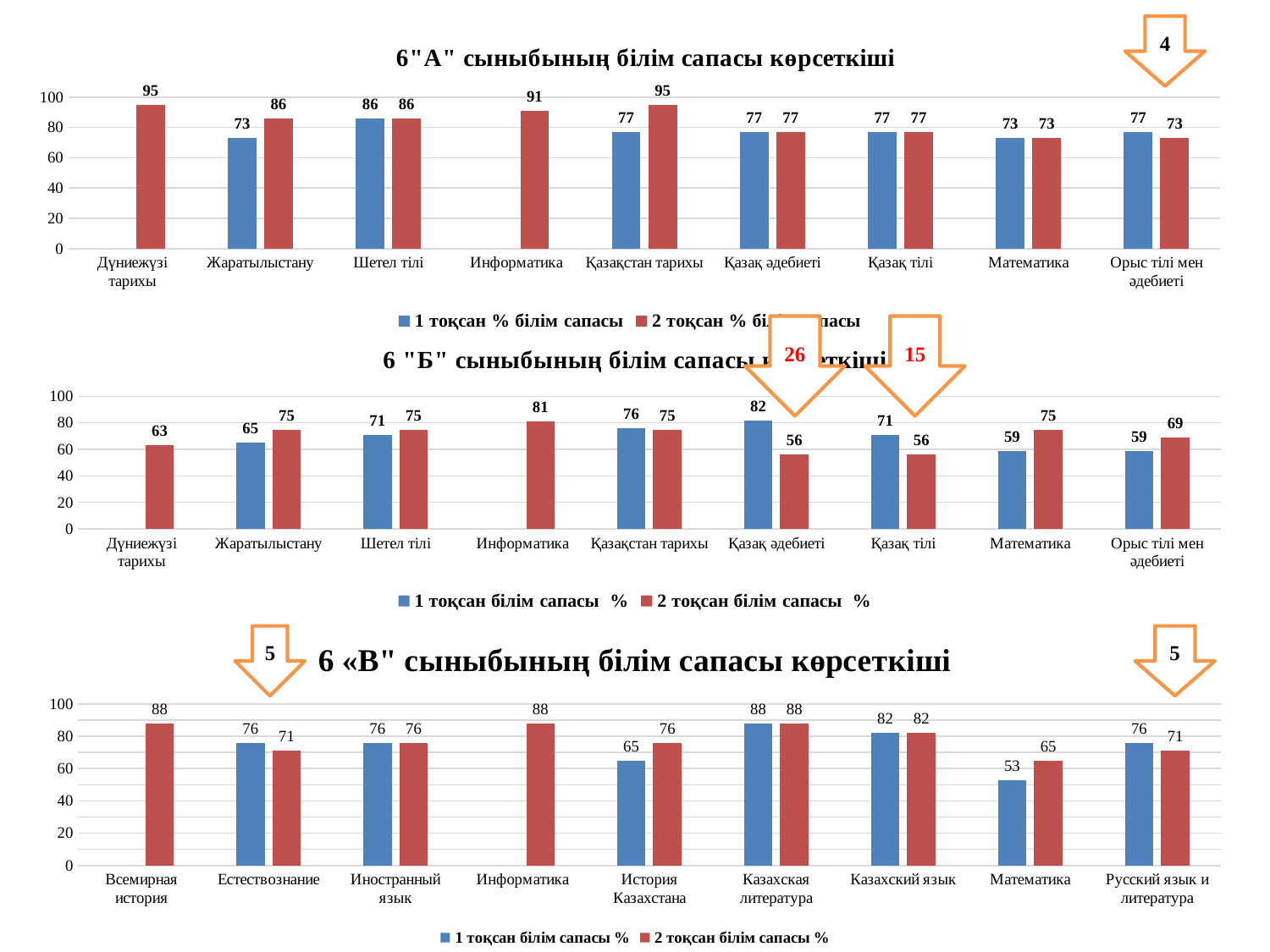
In the chart titled 6"А" сыныбының білім сапасы көрсеткіші, what is the value of the 1 тоқсан series for Жаратылыстану? 73 In the chart titled 6 "Б" сыныбының білім сапасы көрсеткіші, what is the 1 тоқсан value for Қазақ әдебиеті? 82 In the chart titled 6 «В" сыныбының білім сапасы көрсеткіші, how many categories are shown on the x axis? 9 In the chart titled 6 "Б" сыныбының білім сапасы көрсеткіші, which is larger for Математика: the 1 тоқсан value or the 2 тоқсан value? 2 тоқсан (75) In the chart titled 6"А" сыныбының білім сапасы көрсеткіші, what is the value of the 2 тоқсан series for Қазақстан тарихы? 95 In the chart titled 6 «В" сыныбының білім сапасы көрсеткіші, what is the difference between the 2 тоқсан and 1 тоқсан values for История Казахстана? 11 In the chart titled 6"А" сыныбының білім сапасы көрсеткіші, what is the difference between the 2 тоқсан and 1 тоқсан values for Жаратылыстану? 13 What type of chart is the one titled 6 «В" сыныбының білім сапасы көрсеткіші? Bar chart In the chart titled 6 "Б" сыныбының білім сапасы көрсеткіші, which category has the lowest 2 тоқсан value? Қазақ әдебиеті and Қазақ тілі (56) In the chart titled 6 «В" сыныбының білім сапасы көрсеткіші, what colour are the bars for the 1 тоқсан білім сапасы % series? Blue In the chart titled 6 «В" сыныбының білім сапасы көрсеткіші, what is the 1 тоқсан value for Математика? 53 In the chart titled 6 "Б" сыныбының білім сапасы көрсеткіші, how many series does the legend list? 2